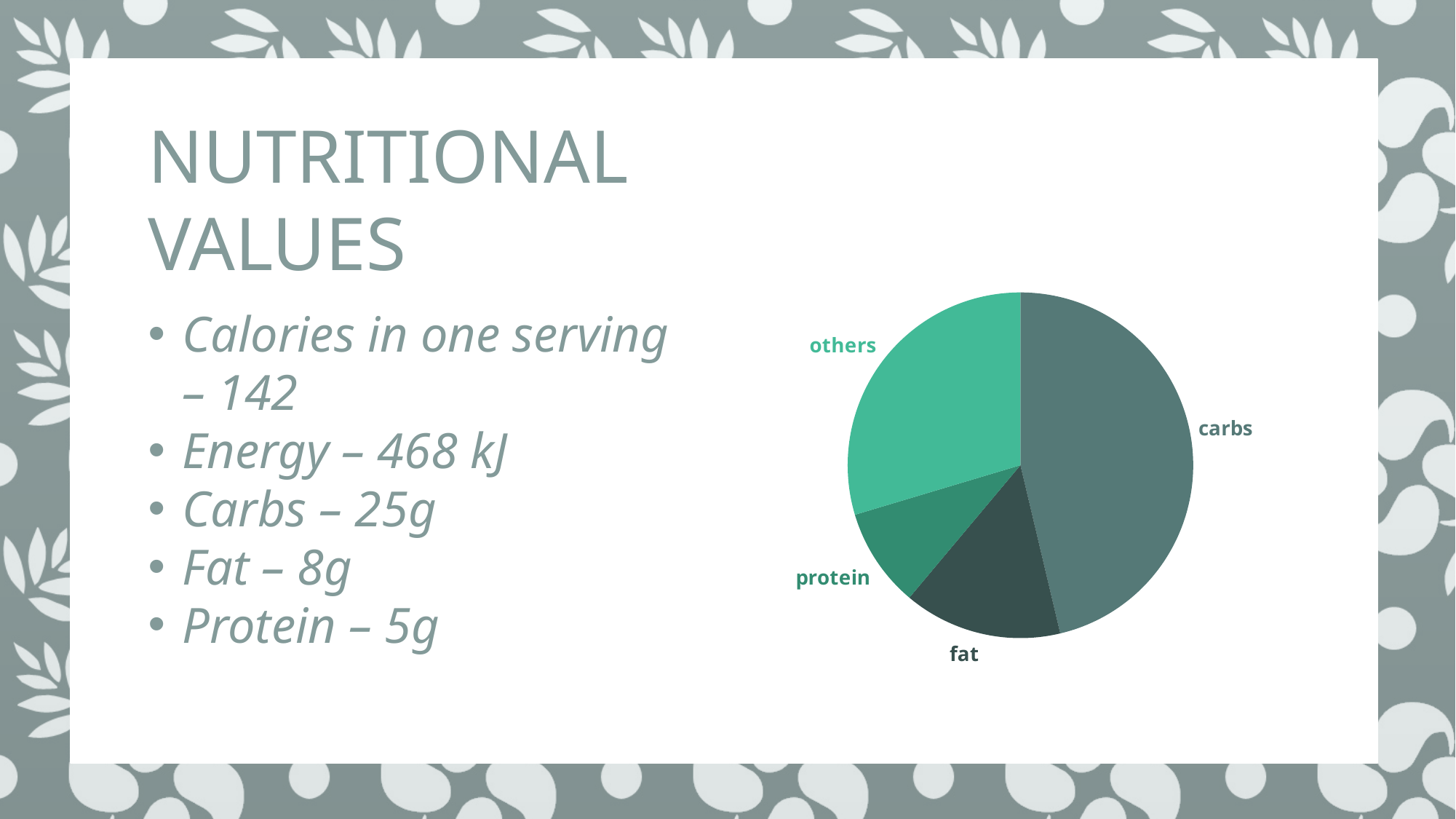
In the pie chart, which slice is larger, fat or protein? fat What are the labels of the slices in the pie chart? carbs, fat, protein, others In the pie chart, which slice is larger, carbs or others? carbs Which slice of the pie chart is the largest? carbs How many slices does the pie chart have? 4 Which slice of the pie chart is the smallest? protein Which slice of the pie chart is the lightest green? others In the pie chart, which slice is larger, others or fat? others What kind of chart is shown on the slide? pie chart